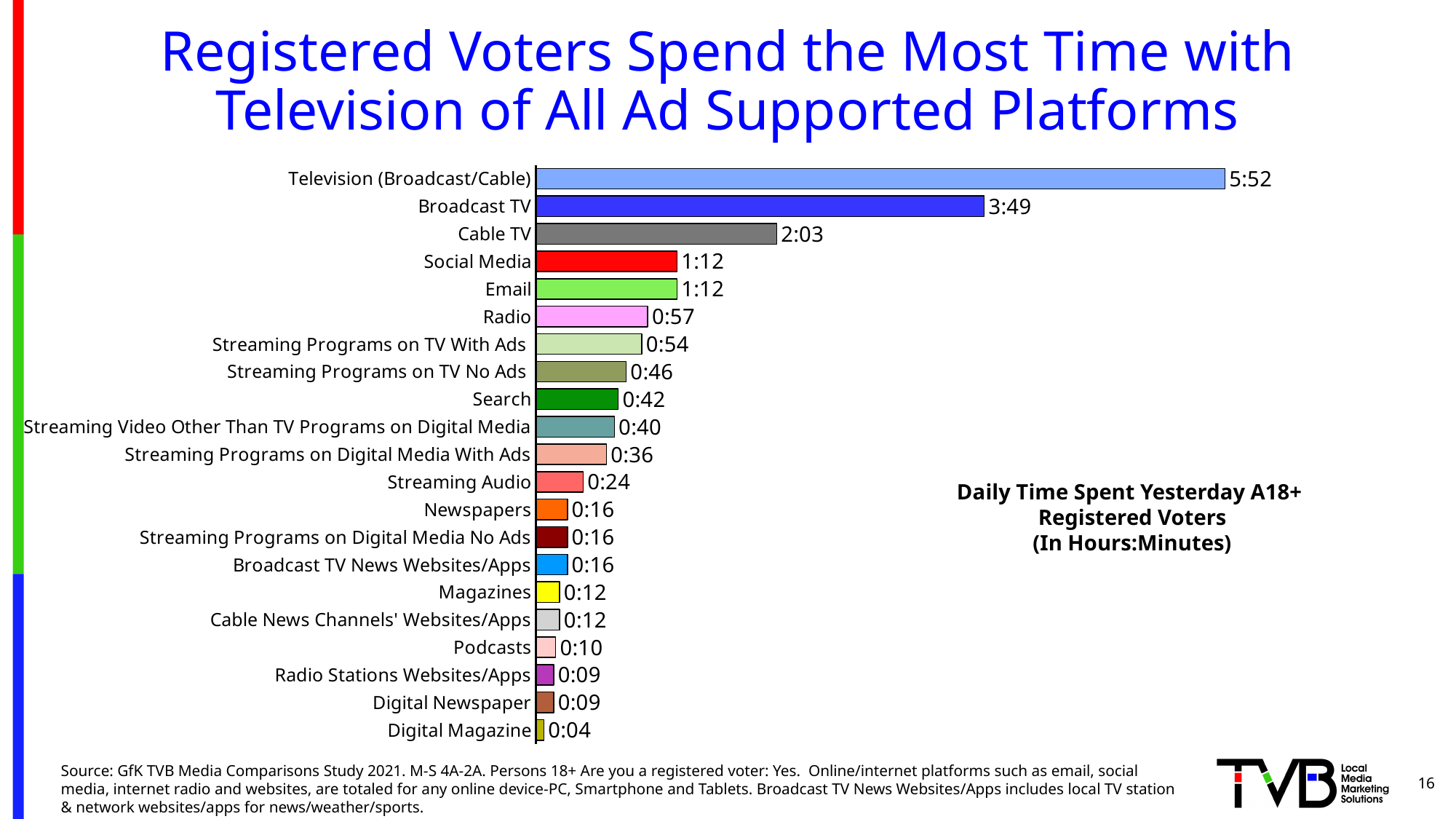
What is the daily time spent with Television (Broadcast/Cable) by registered voters? 5:52 In what units are the values in the chart expressed? Hours:Minutes What is the value shown for Cable TV? 2:03 How many platforms are listed in the chart? 21 What is the value for Streaming Programs on TV With Ads? 0:54 What type of chart is shown on the slide? Bar chart Which has a larger value, Search or Streaming Audio? Search What is the difference in daily time spent between Television (Broadcast/Cable) and Broadcast TV? 2:03 Which platform has the lowest daily time spent? Digital Magazine Which platform has the highest daily time spent? Television (Broadcast/Cable) What is the difference between Radio and Streaming Audio? 0:33 How much daily time is shown for Podcasts? 0:10